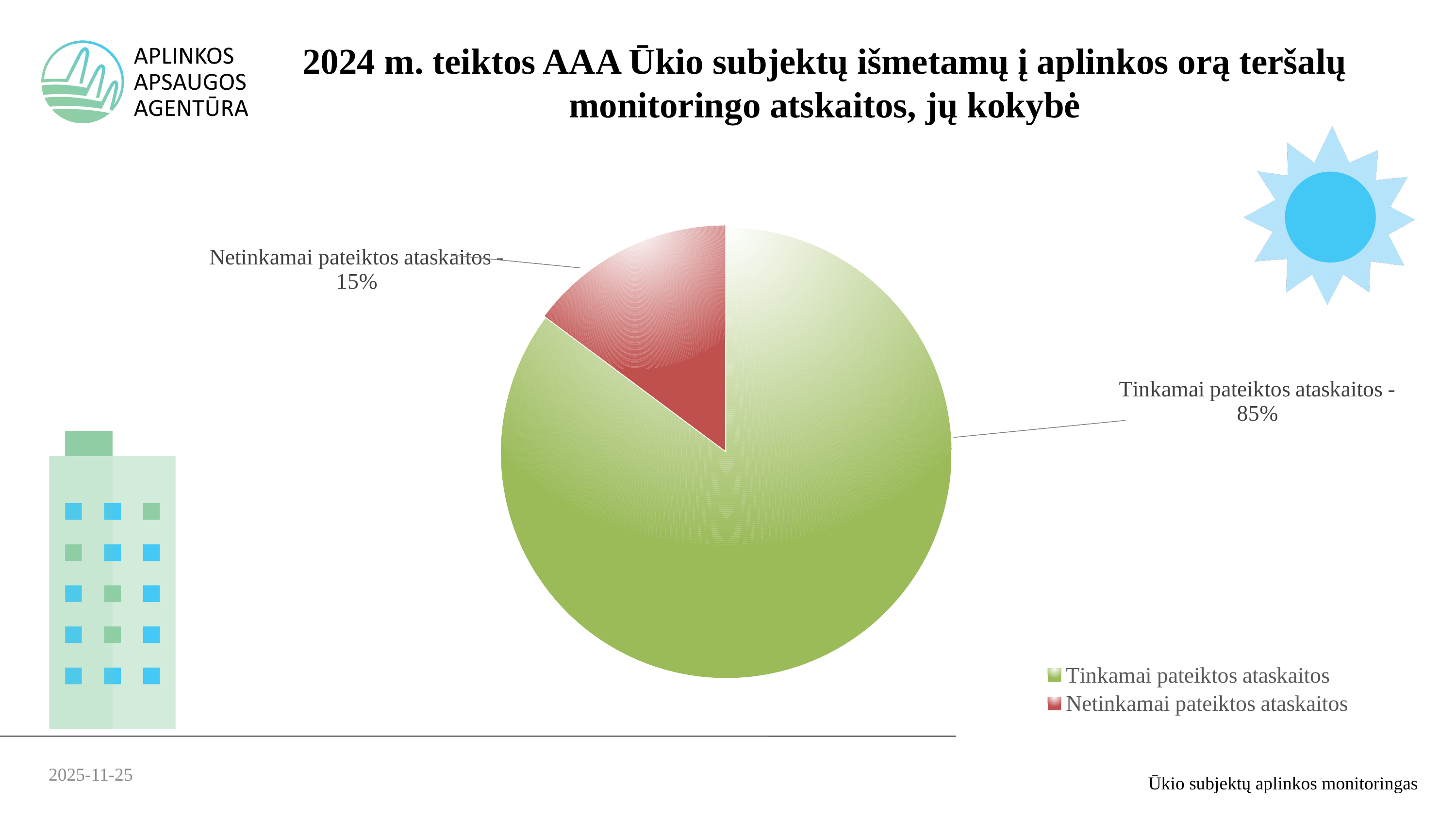
What is the difference in percentage points between "Tinkamai pateiktos ataskaitos" and "Netinkamai pateiktos ataskaitos"? 70 What colour is the "Tinkamai pateiktos ataskaitos" slice? green What kind of chart is shown on the slide? pie chart How many slices does the pie chart have? 2 Which is larger: "Tinkamai pateiktos ataskaitos" or "Netinkamai pateiktos ataskaitos"? Tinkamai pateiktos ataskaitos What share of the pie is "Tinkamai pateiktos ataskaitos"? 85% How many entries does the legend list? 2 Which slice of the pie is the largest? Tinkamai pateiktos ataskaitos Which slice of the pie is the smallest? Netinkamai pateiktos ataskaitos What colour is the "Netinkamai pateiktos ataskaitos" slice? red What share of the pie is "Netinkamai pateiktos ataskaitos"? 15%